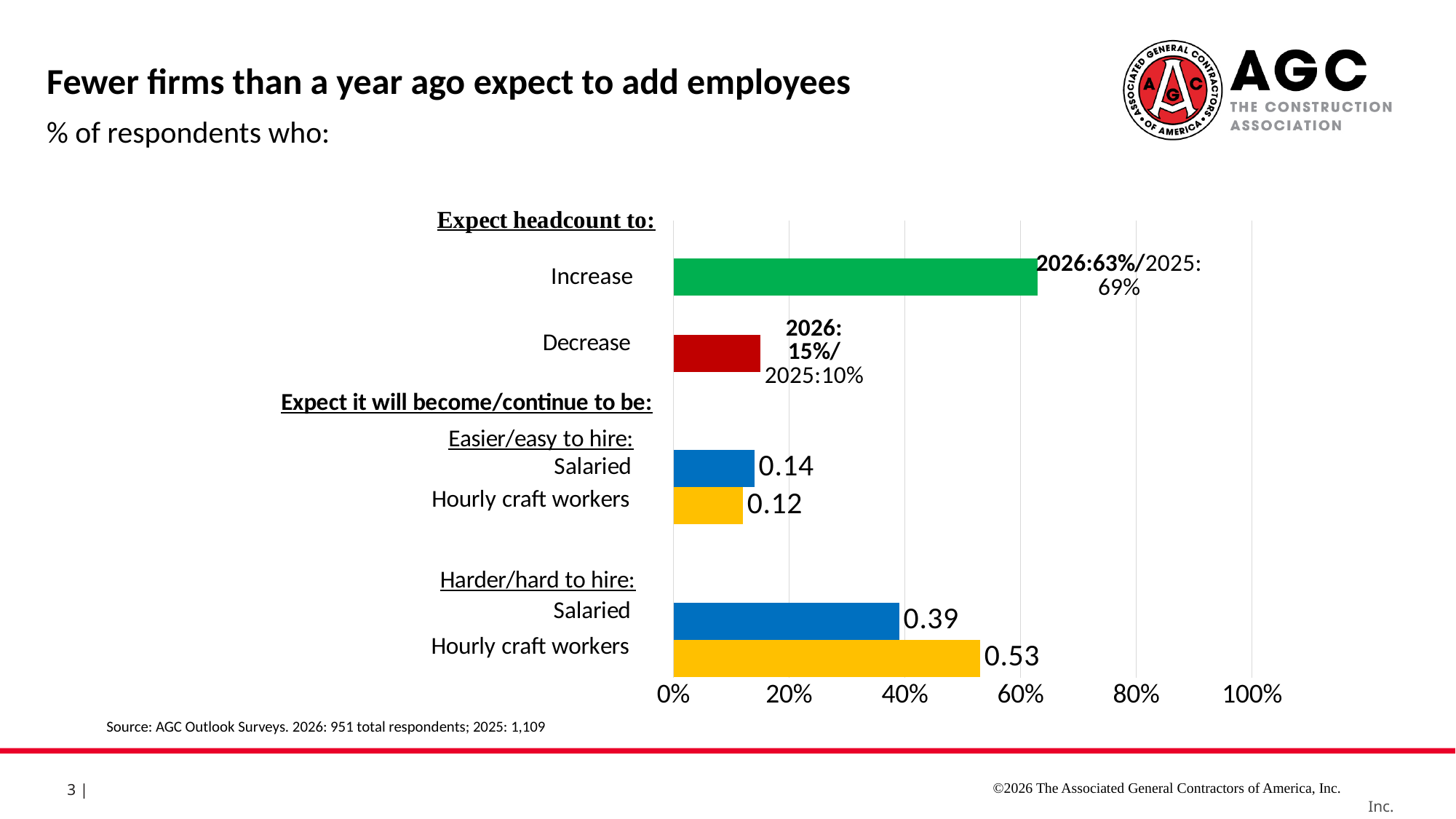
What is the value shown for Salaried under 'Easier/easy to hire'? 0.14 Which bar in the chart is the longest? Increase What is the difference between the 2026 percentages for Increase and Decrease? 48 percentage points What percentage of respondents expect headcount to increase in 2026? 63% Under 'Harder/hard to hire', what is the difference between the Hourly craft workers value and the Salaried value? 0.14 Which bar in the chart is the shortest? Hourly craft workers (Easier/easy to hire) What kind of chart is shown on the slide? bar chart What percentage of respondents expected headcount to increase in 2025? 69% What percentage of respondents expect headcount to decrease in 2026? 15% Under 'Harder/hard to hire', which is larger: Salaried or Hourly craft workers? Hourly craft workers What is the value shown for Hourly craft workers under 'Harder/hard to hire'? 0.53 How many bars are plotted in the chart? 6